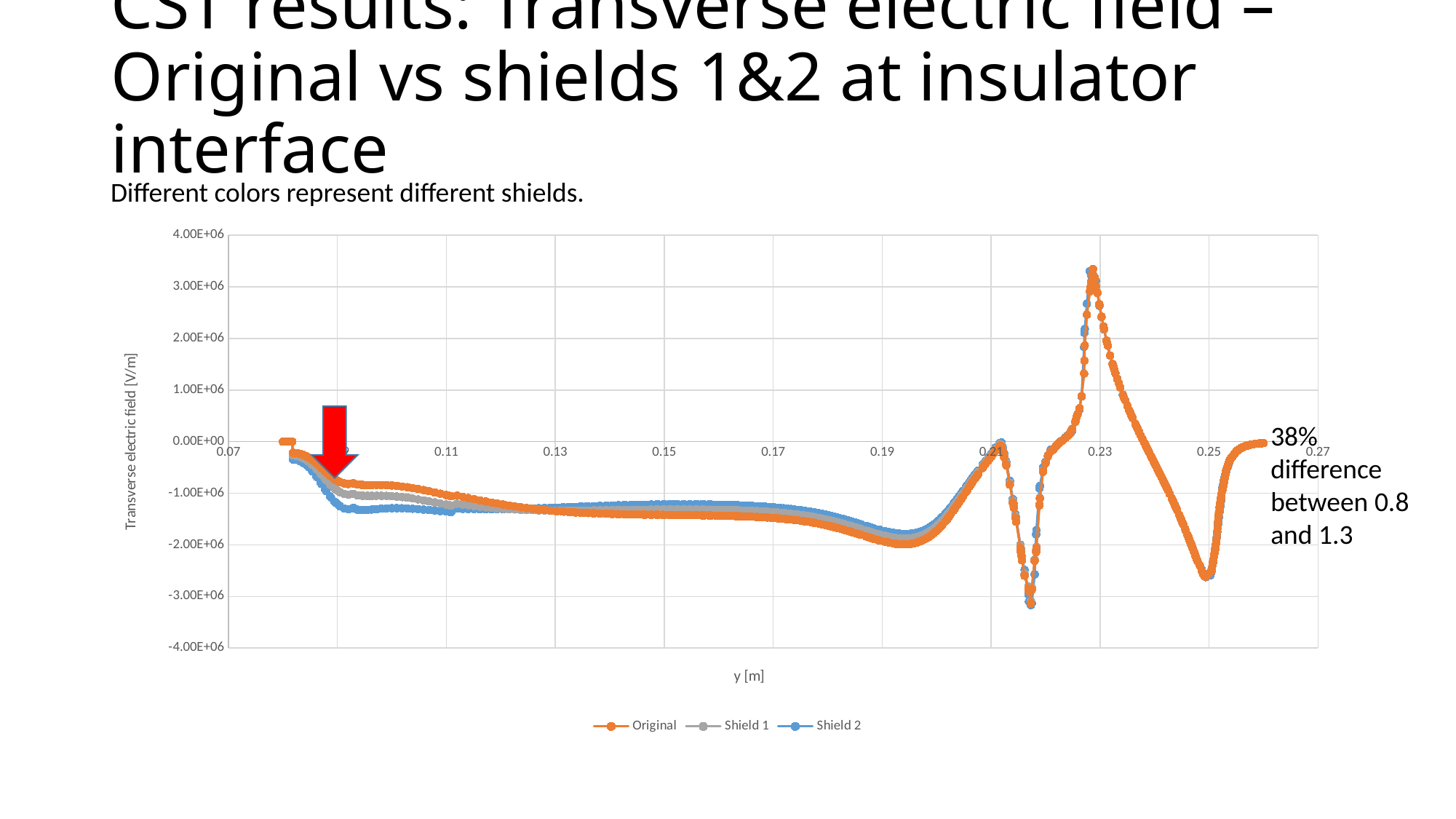
Near y = 0.09 (where the red arrow points), which series has the lowest (most negative) value? Shield 2 What is the label of the vertical axis? Transverse electric field [V/m] What are the three series named in the legend? Original, Shield 1, Shield 2 What kind of chart is shown on the slide? Line chart Is the minimum of the Original series near y = 0.25 greater or less than -2.00E+06? less Does the Original series rise or fall between y = 0.21 and y = 0.23? Rise Is the value of the Original series at y = 0.15 greater or less than -2.00E+06? greater Near y = 0.09 (where the red arrow points), which series has the higher (less negative) value, Original or Shield 2? Original Is the value of the Original series at y = 0.15 greater or less than -1.00E+06? less How many series does the legend list? 3 Does the Original series rise or fall between y = 0.23 and y = 0.25? Fall